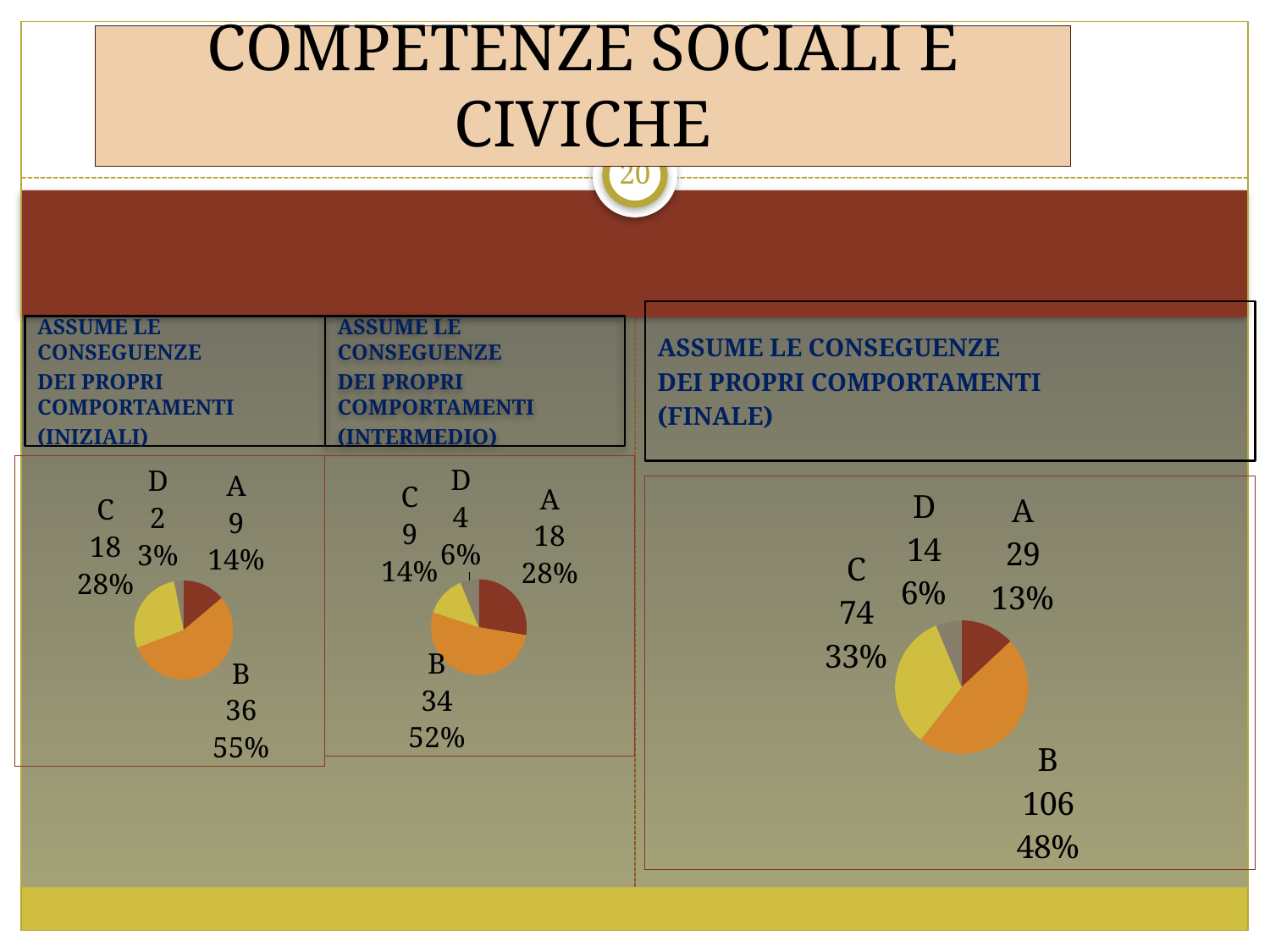
In the (INIZIALI) pie chart, which category has the smallest value? D In the (INTERMEDIO) pie chart, what is the difference between the values for B and A? 16 In the (FINALE) pie chart, what share of the pie does category B represent? 48% How many pie charts are shown on the slide? 3 In the (INIZIALI) pie chart, what share of the pie does category C represent? 28% In the (FINALE) pie chart, what is the value for category C? 74 In the (INTERMEDIO) pie chart, which category has the largest value? B In the (FINALE) pie chart, which is larger, the value for A or the value for D? A How many categories are shown in the (FINALE) pie chart? 4 In the (INIZIALI) pie chart, what is the value for category B? 36 What kind of chart is used in the 'ASSUME LE CONSEGUENZE DEI PROPRI COMPORTAMENTI (FINALE)' chart? pie chart In the (INTERMEDIO) pie chart, what is the value for category A? 18